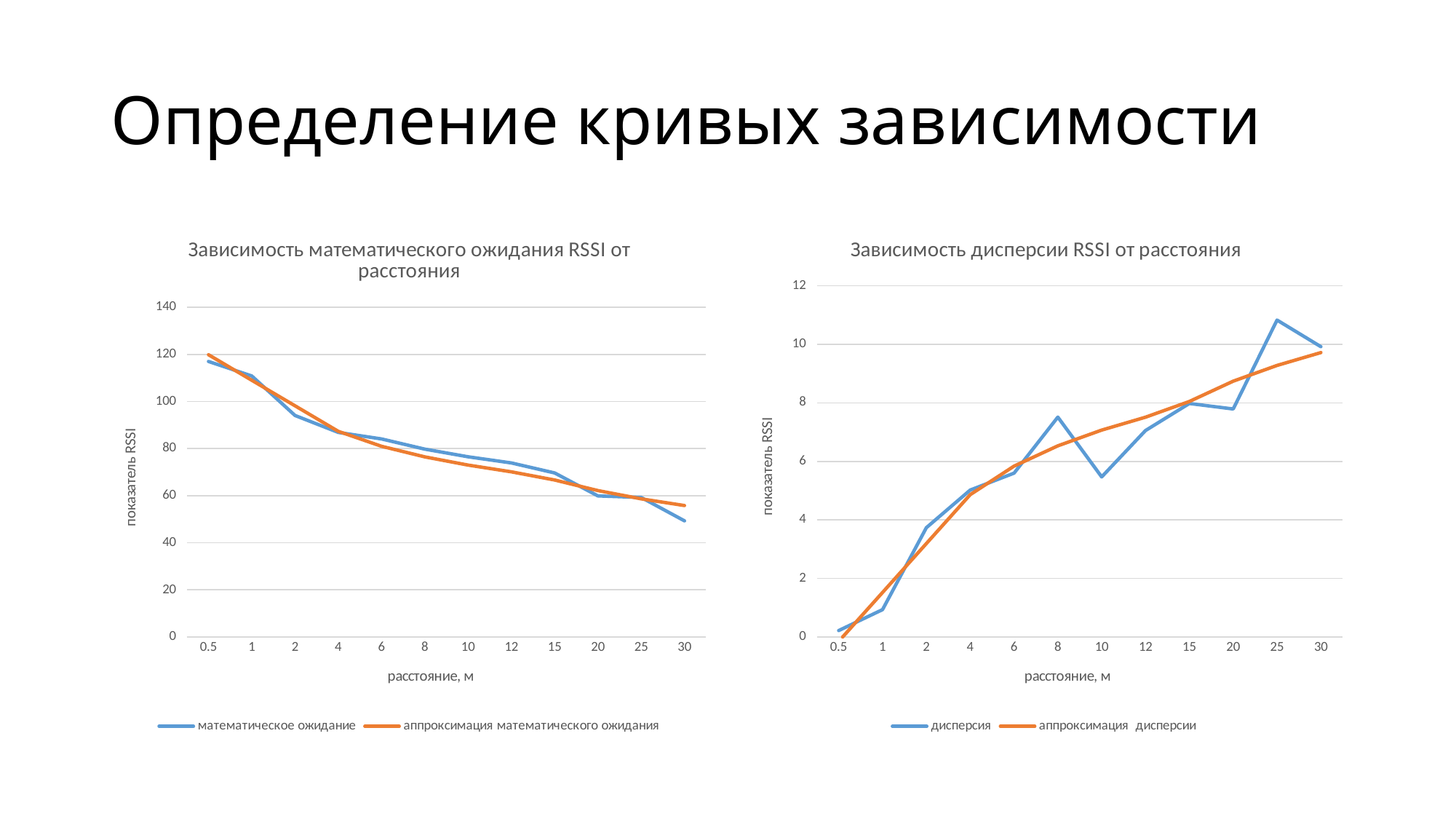
In the right chart, 'Зависимость дисперсии RSSI от расстояния', is the value of 'дисперсия' at distance 10 greater or less than 6? less In the left chart, 'Зависимость математического ожидания RSSI от расстояния', is the value of 'математическое ожидание' at distance 0.5 greater or less than 100? greater In the right chart, 'Зависимость дисперсии RSSI от расстояния', is the value of 'дисперсия' at distance 8 larger or smaller than at distance 10? larger In the right chart, 'Зависимость дисперсии RSSI от расстояния', at which distance is 'дисперсия' highest? 25 How many distance points are plotted along the x axis of the left chart, 'Зависимость математического ожидания RSSI от расстояния'? 12 In the right chart, 'Зависимость дисперсии RSSI от расстояния', do the values of 'аппроксимация дисперсии' rise or fall as distance increases? rise How many series does the legend of the right chart, 'Зависимость дисперсии RSSI от расстояния', list? 2 What kind of chart is the left chart, 'Зависимость математического ожидания RSSI от расстояния'? line chart In the left chart, 'Зависимость математического ожидания RSSI от расстояния', at which distance is 'математическое ожидание' highest? 0.5 In the left chart, 'Зависимость математического ожидания RSSI от расстояния', do the values of 'математическое ожидание' rise or fall as distance increases? fall What is the x-axis label of the right chart, 'Зависимость дисперсии RSSI от расстояния'? расстояние, м In the left chart, 'Зависимость математического ожидания RSSI от расстояния', at which distance is 'математическое ожидание' lowest? 30